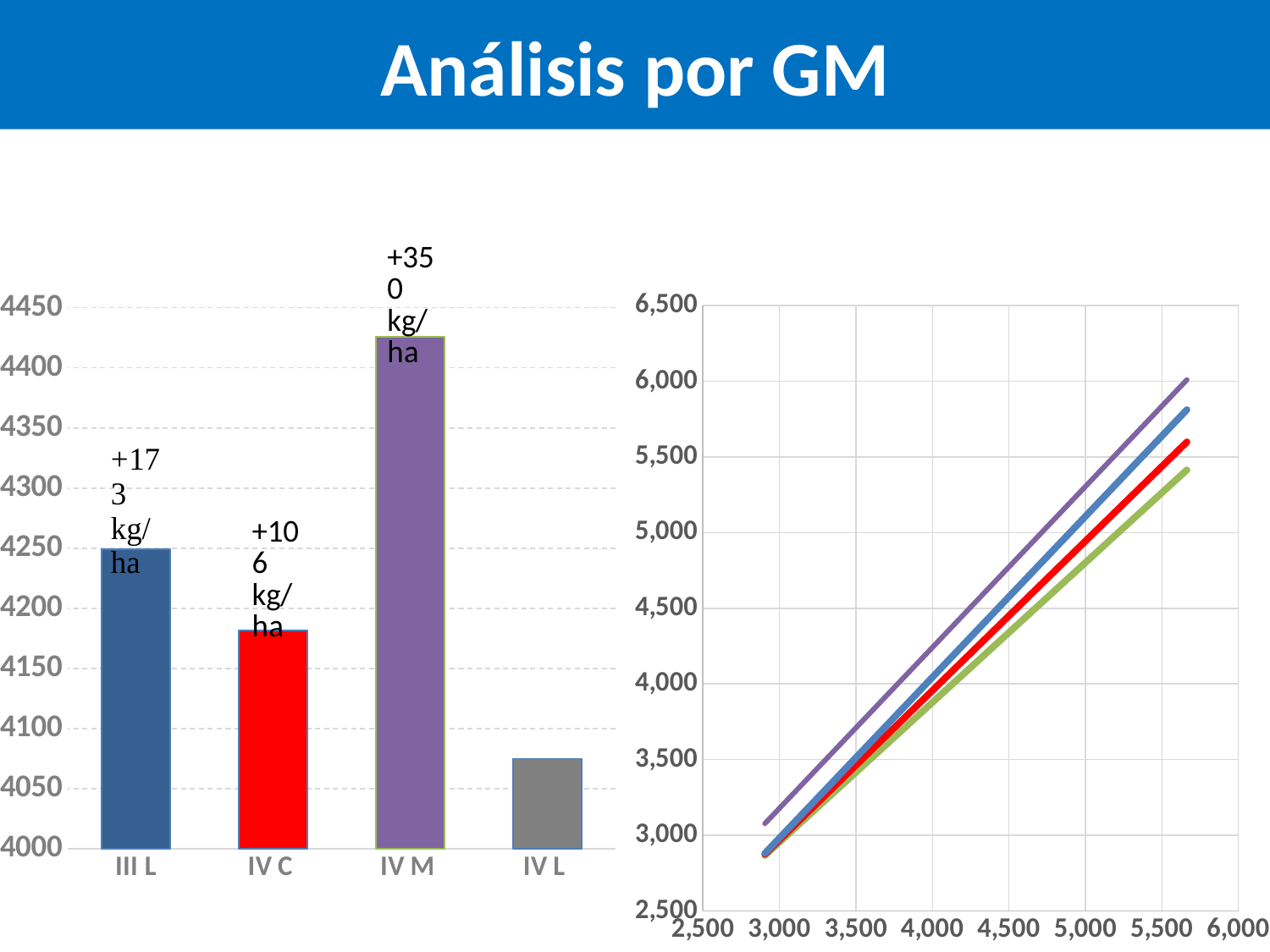
In the line chart on the right, do the lines rise or fall as the x-axis value increases? rise In the bar chart on the left, is the value for IV M greater or less than 4400? greater What kind of chart is the chart on the left of the slide? bar chart In the bar chart on the left, which bar is taller, III L or IV C? III L In the bar chart on the left, what annotation is written above the IV M bar? +350 kg/ha In the bar chart on the left, is the value for IV L greater or less than 4100? less In the bar chart on the left, which category has the highest bar? IV M In the bar chart on the left, how many categories are shown on the x axis? 4 In the bar chart on the left, which category has the lowest bar? IV L In the bar chart on the left, is the value for IV C greater or less than 4200? less In the line chart on the right, how many lines are plotted? 4 What kind of chart is the chart on the right of the slide? line chart